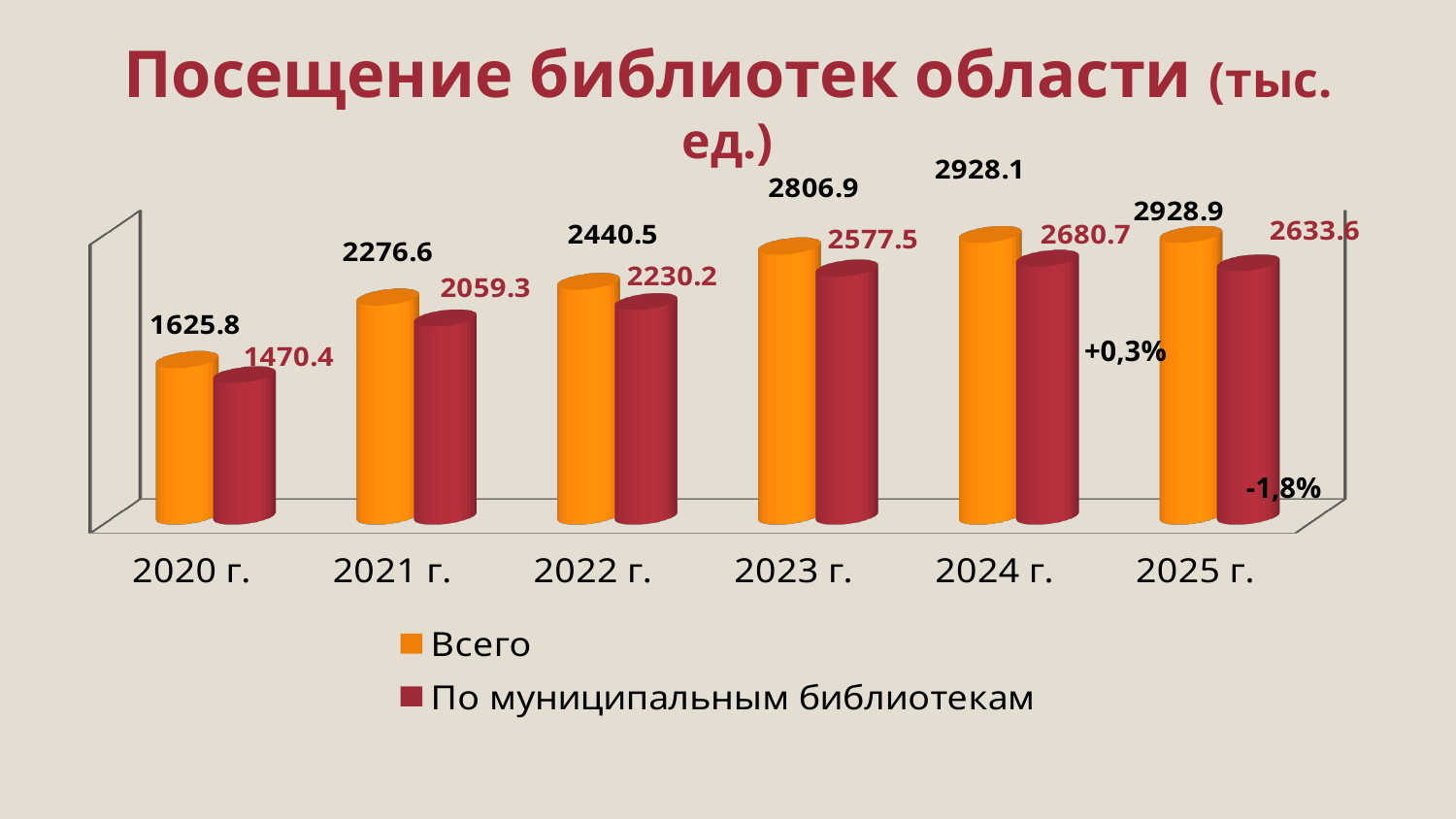
What is the difference between "Всего" and "По муниципальным библиотекам" in 2020 г.? 155.4 Which is larger: "Всего" in 2022 г. or "По муниципальным библиотекам" in 2023 г.? По муниципальным библиотекам in 2023 г. What is the value for "Всего" in 2025 г.? 2928.9 What is the difference between the "По муниципальным библиотекам" values for 2024 г. and 2025 г.? 47.1 Which year has the lowest value for "Всего"? 2020 г. What is the value for "По муниципальным библиотекам" in 2021 г.? 2059.3 How many years are shown on the x axis? 6 What is the value for "По муниципальным библиотекам" in 2023 г.? 2577.5 What kind of chart is shown on the slide? Bar chart How many series does the legend list? 2 What is the value for "Всего" in 2020 г.? 1625.8 Does the "Всего" series rise or fall from 2020 г. to 2025 г.? Rises